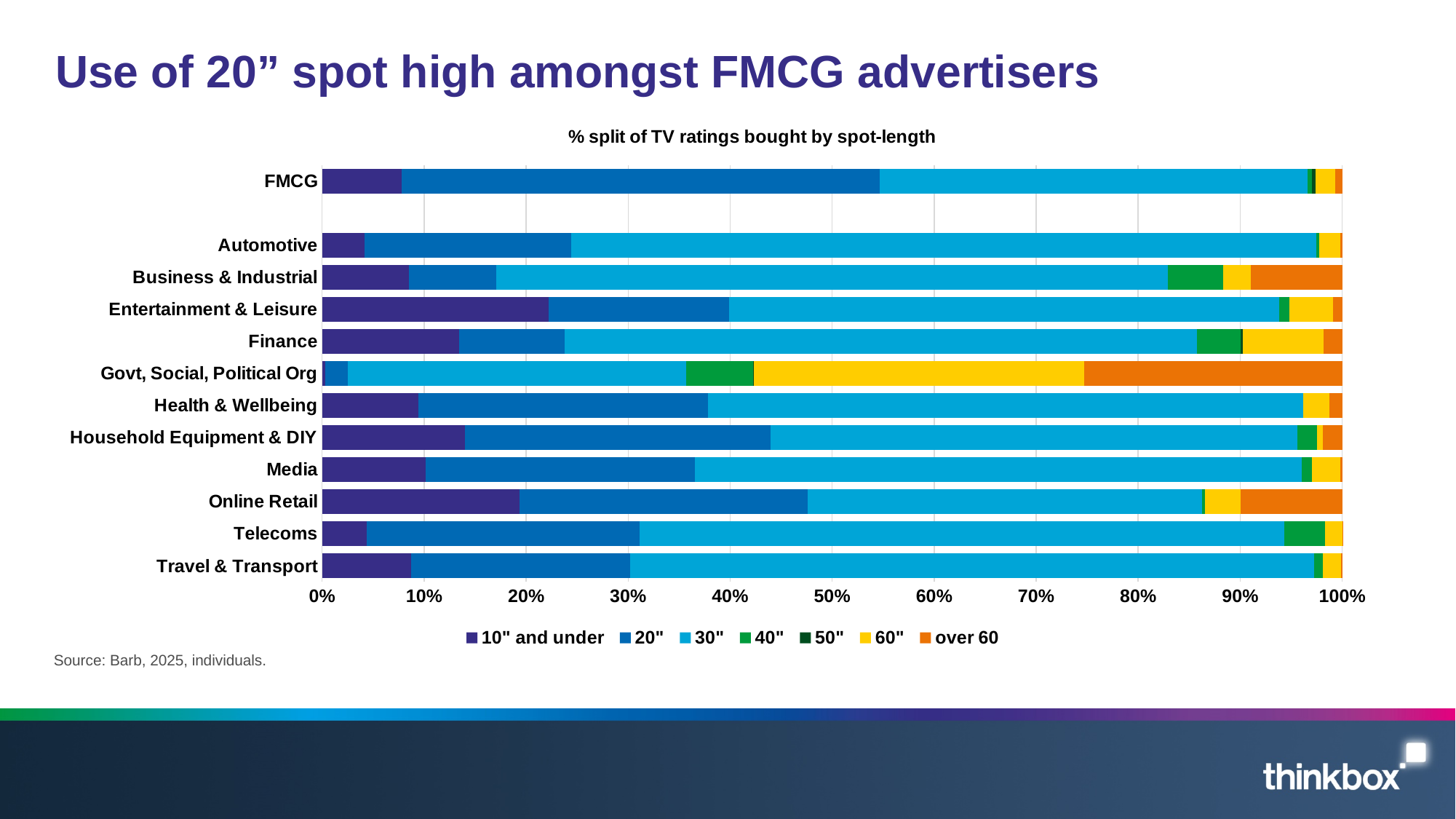
Which category has the smallest "10" and under" segment? Govt, Social, Political Org How many advertiser categories are plotted on the chart? 12 How many series does the legend list? 7 Is the "over 60" share for Govt, Social, Political Org greater or less than 20%? greater What kind of chart is shown on the slide? Stacked bar chart Which category has the larger 20" segment, FMCG or Automotive? FMCG Is the combined share of "10" and under" and 20" for FMCG greater or less than 50%? greater Which category has the larger "10" and under" segment, Entertainment & Leisure or Telecoms? Entertainment & Leisure What is the title of the chart? % split of TV ratings bought by spot-length Which category has the largest 20" segment? FMCG Which category has the largest "over 60" segment? Govt, Social, Political Org Which category has the largest 60" segment? Govt, Social, Political Org